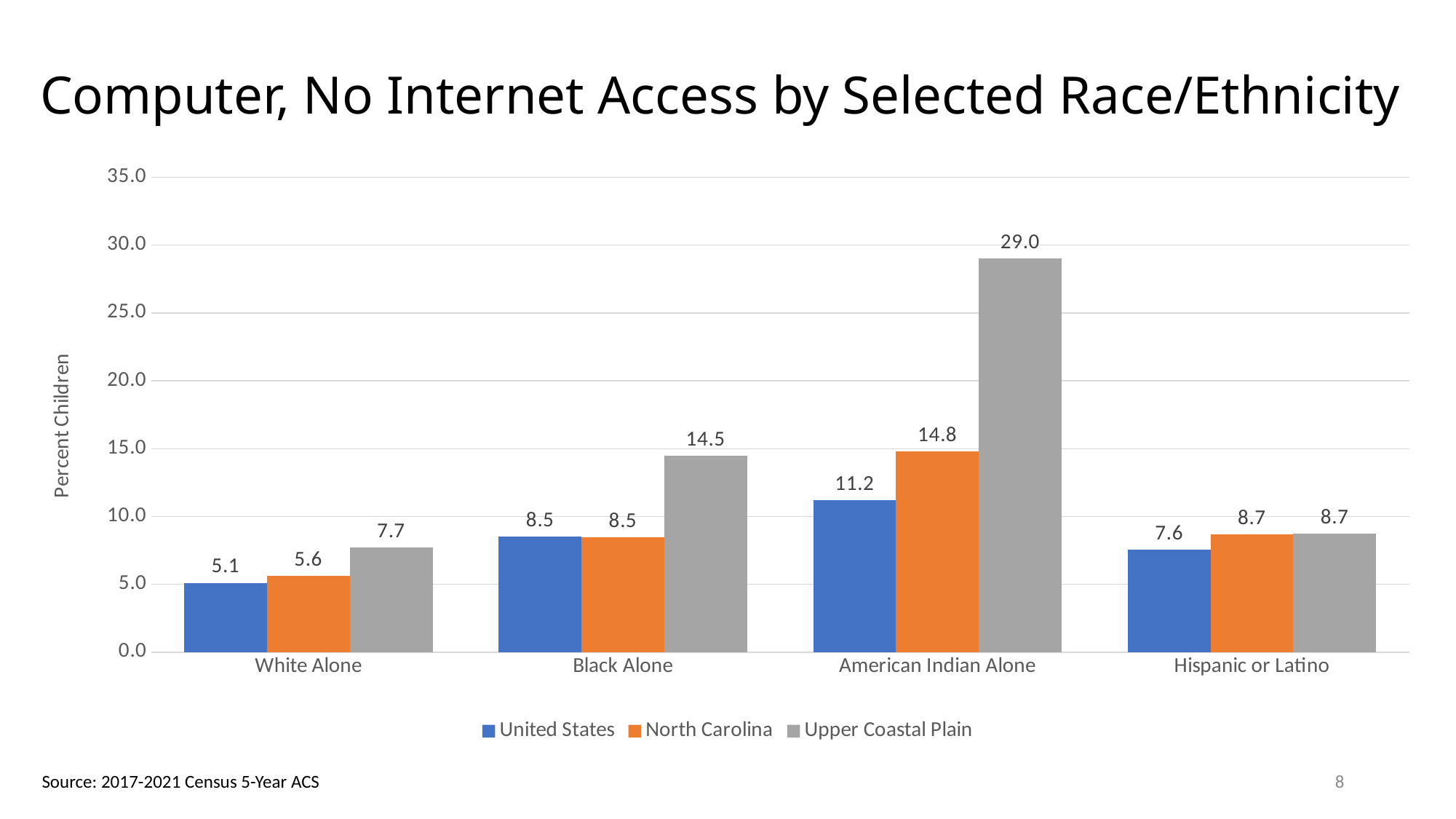
What is the value for North Carolina in the Hispanic or Latino category? 8.7 Which category has the lowest United States value? White Alone What is the value for United States in the White Alone category? 5.1 What is the difference between the Upper Coastal Plain and North Carolina values for American Indian Alone? 14.2 Which is larger, the Upper Coastal Plain value for Black Alone or the North Carolina value for American Indian Alone? North Carolina value for American Indian Alone What is the value for Upper Coastal Plain in the American Indian Alone category? 29.0 What is the difference between the Upper Coastal Plain and United States values for Black Alone? 6.0 Is the Upper Coastal Plain value for American Indian Alone greater or less than 25.0? greater What kind of chart is shown on the slide? Bar chart How many race/ethnicity categories are shown on the x axis? 4 Which category has the highest Upper Coastal Plain value? American Indian Alone How many series does the legend list? 3